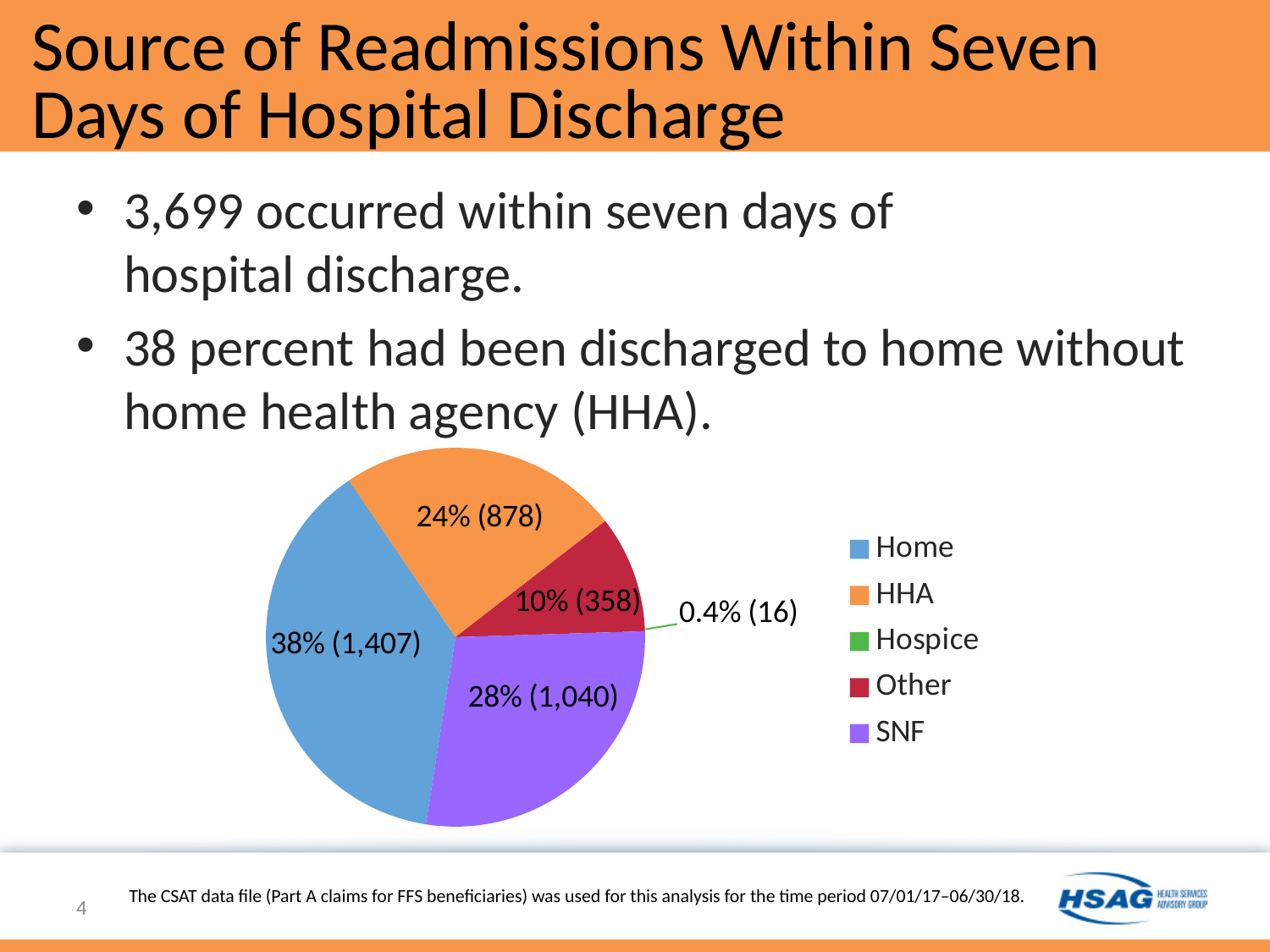
Which category has the smallest share of the pie chart? Hospice Which category has the largest share of the pie chart? Home Which colour represents SNF in the pie chart legend? Purple What is the data label shown for the SNF slice of the pie chart? 28% (1,040) What percentage share of the pie does the Other slice represent? 10% What is the data label shown for the Hospice slice of the pie chart? 0.4% (16) What is the data label shown for the HHA slice of the pie chart? 24% (878) Which slice is larger, HHA or Other? HHA What is the data label shown for the Home slice of the pie chart? 38% (1,407) What type of chart is shown on the slide? Pie chart How many categories does the pie chart show? 5 What is the difference in count between the Home slice and the SNF slice? 367